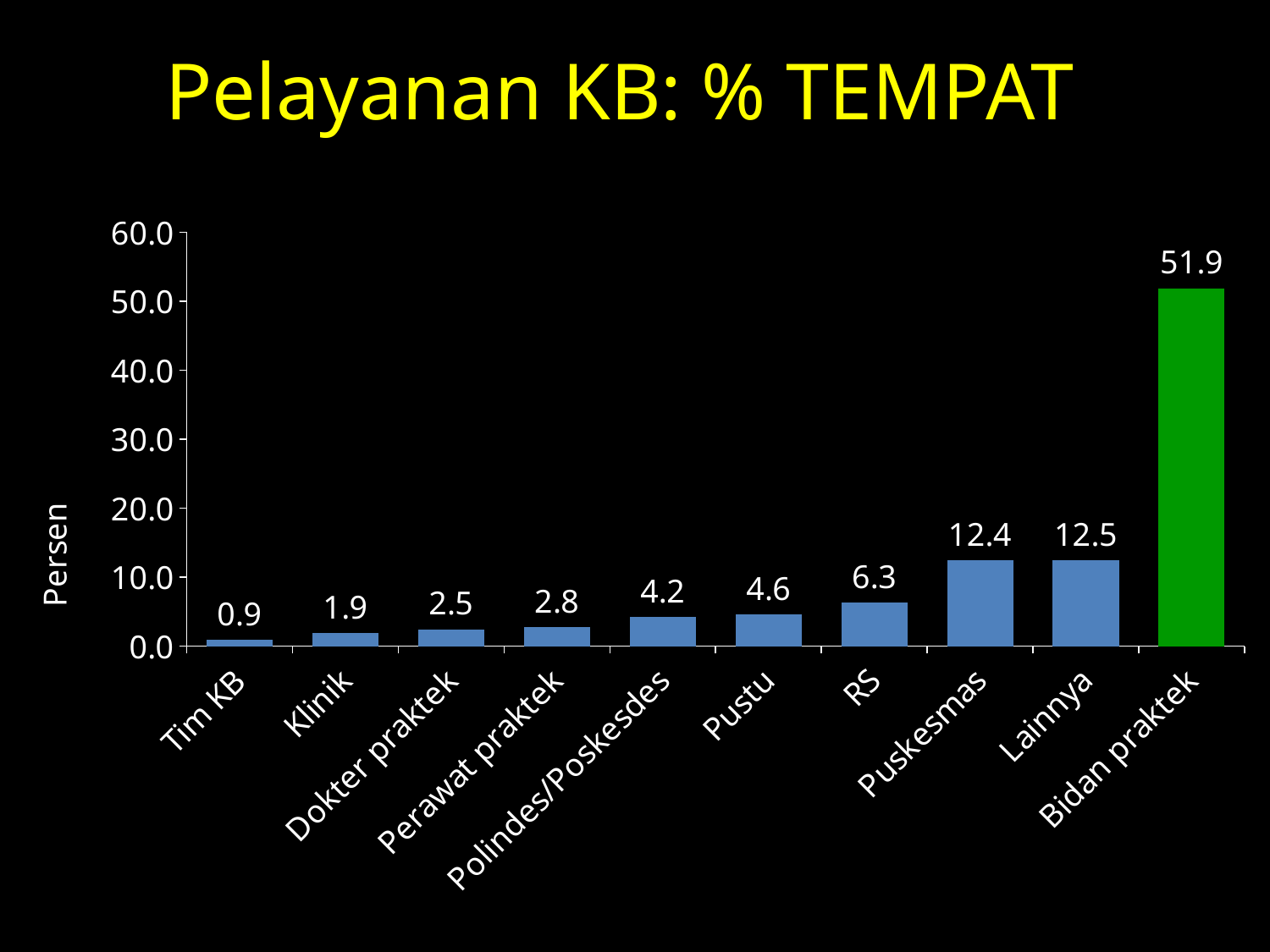
Which category has the highest value? Bidan praktek Which is larger, the value for Klinik or the value for Perawat praktek? Perawat praktek What is the difference between the values for RS and Pustu? 1.7 Which category has the lowest value? Tim KB What is the value for Polindes/Poskesdes? 4.2 How many categories are shown on the x axis? 10 What kind of chart is shown on the slide? bar chart What is the value for Puskesmas? 12.4 Is the value for Bidan praktek greater or less than 50.0? greater What is the title of the chart? Pelayanan KB: % TEMPAT What is the difference between the values for Bidan praktek and Lainnya? 39.4 What is the value for Bidan praktek? 51.9